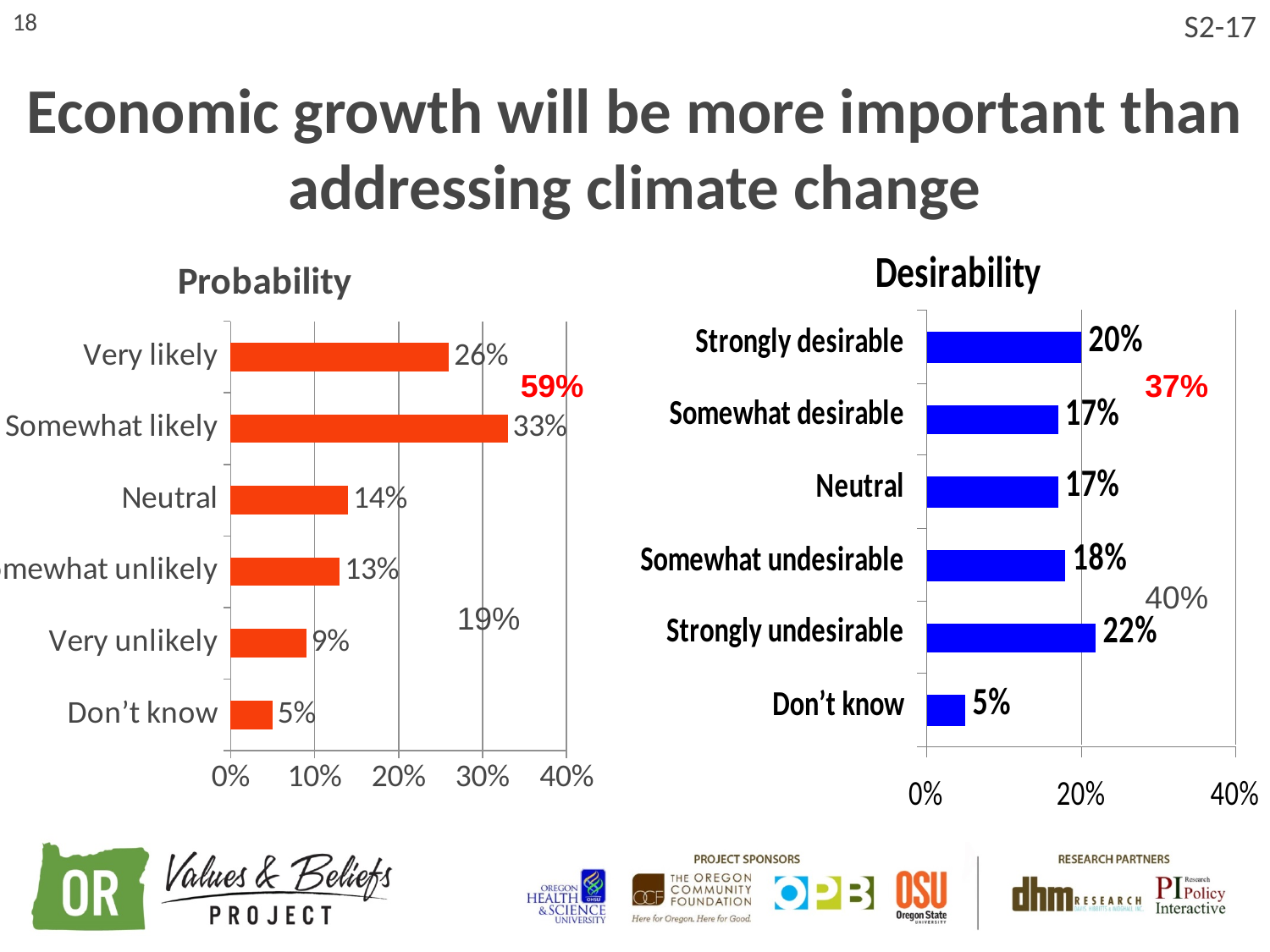
In the Probability chart, which category has the highest value? Somewhat likely In the Desirability chart, what is the value for Strongly undesirable? 22% In the Desirability chart, which is larger, the value for Strongly undesirable or the value for Strongly desirable? Strongly undesirable In the Probability chart, what is the difference between the values for Somewhat likely and Very likely? 7% How many categories are shown in the Desirability chart? 6 In the Desirability chart, which category has the lowest value? Don't know What kind of chart is the Probability chart? bar chart In the Probability chart, is the value for Very likely greater or less than 20%? greater In the Desirability chart, what is the value for Strongly desirable? 20% In the Probability chart, what is the value for Very likely? 26% What colour are the bars in the Desirability chart? blue In the Probability chart, what is the value for Somewhat likely? 33%